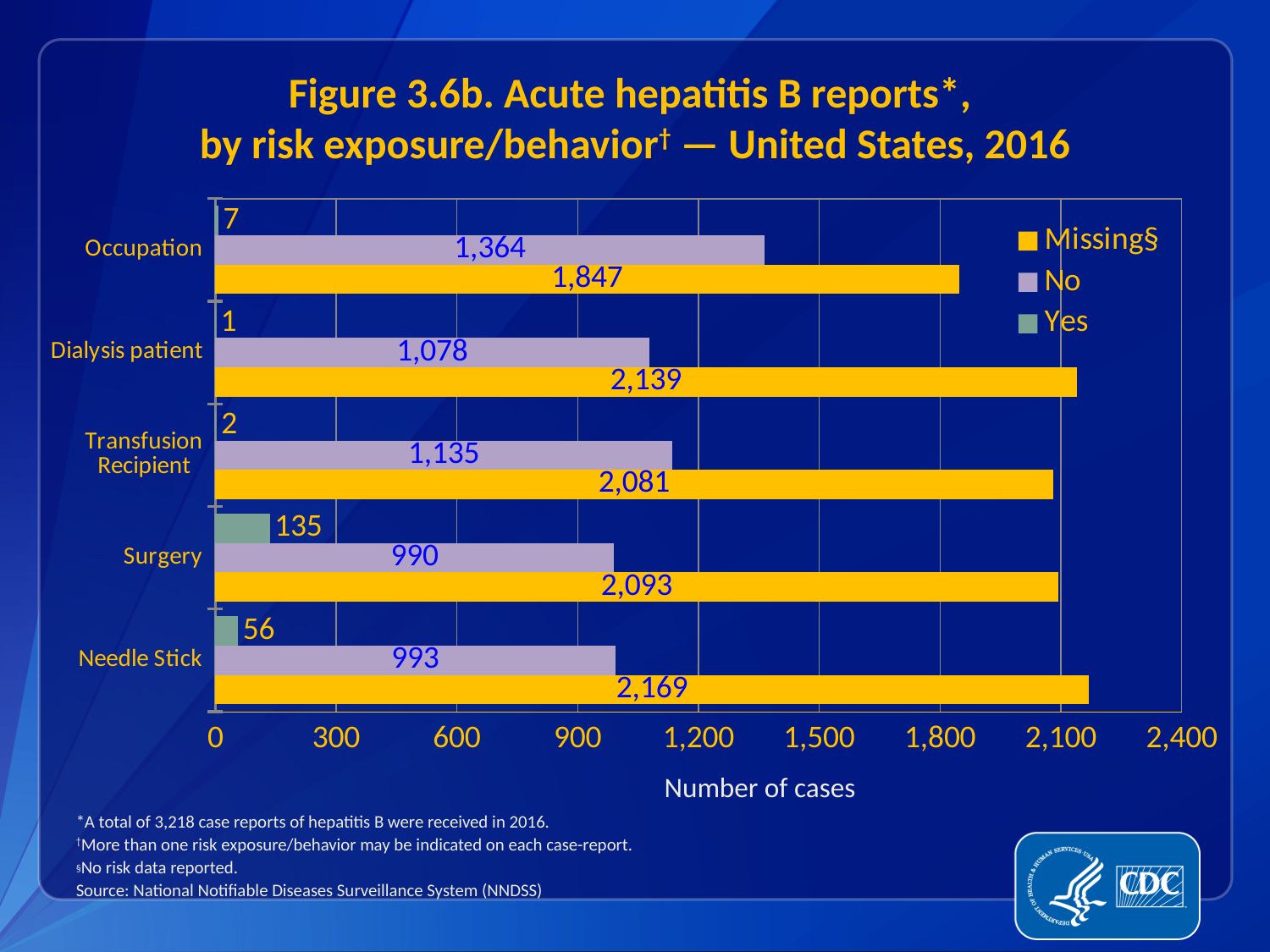
How many risk exposure/behavior categories are shown on the chart? 5 What is the 'Yes' value for Surgery? 135 Which is larger, the 'No' value for Surgery or the 'No' value for Needle Stick? Needle Stick Which risk exposure/behavior has the lowest 'Missing' value? Occupation What is the number of cases with 'Missing' risk data for Needle Stick? 2,169 What is the difference between the 'Missing' and 'No' values for Transfusion Recipient? 946 Which risk exposure/behavior has the highest 'Yes' value? Surgery How many series does the legend list? 3 What is the 'Yes' value for Dialysis patient? 1 What kind of chart is shown on the slide? Bar chart What is the label of the x axis? Number of cases What is the 'No' value for Occupation? 1,364